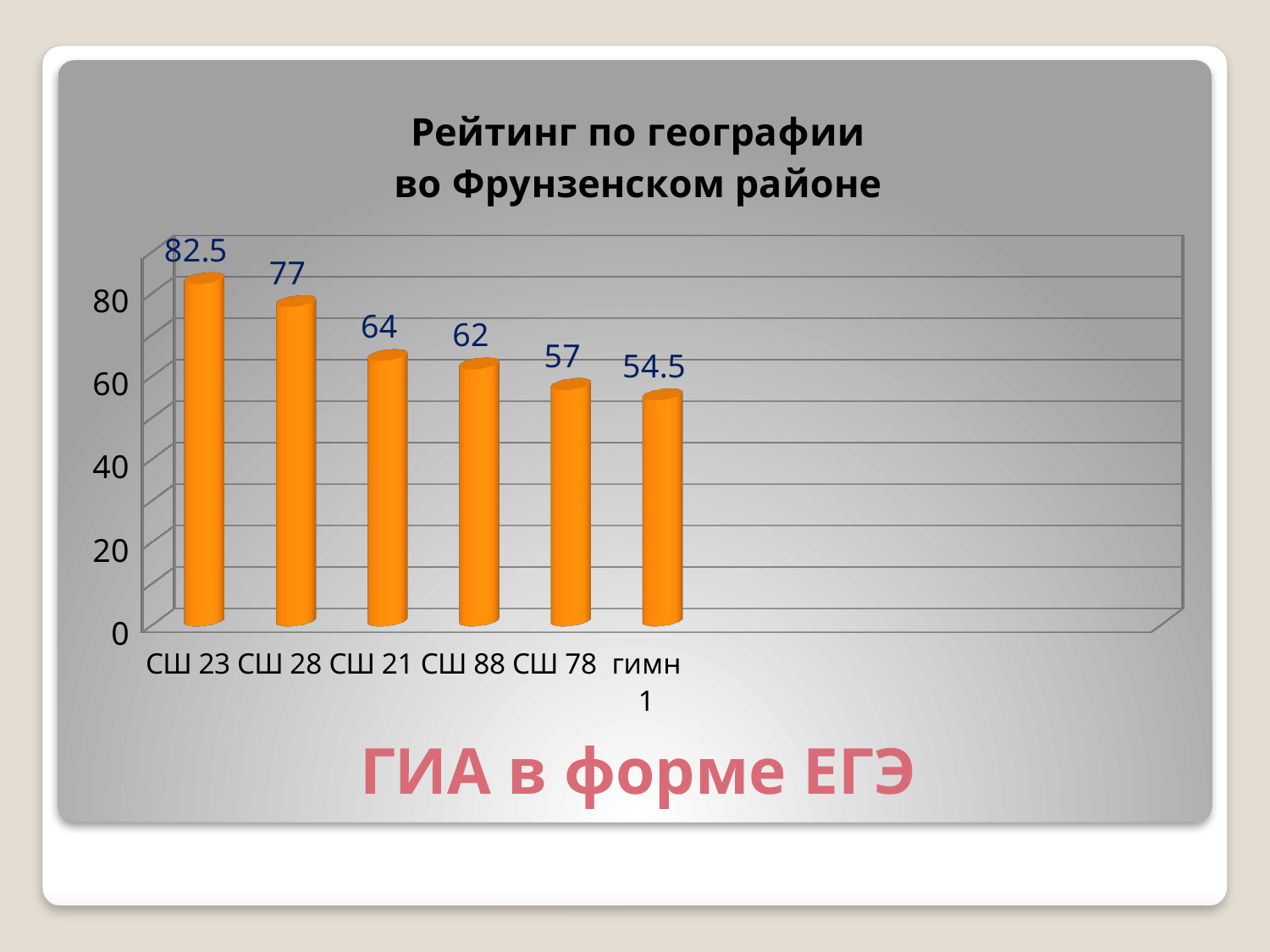
What is the value for гимн 1? 54.5 Is the value for СШ 78 greater or less than 60? less What is the difference between the values for СШ 23 and СШ 28? 5.5 Which category has the lowest value? гимн 1 What is the value for СШ 23? 82.5 Do the values rise or fall from left to right along the x axis? fall What is the difference between the values for СШ 21 and СШ 78? 7 Which is larger, the value for СШ 28 or the value for СШ 21? СШ 28 What kind of chart is shown on the slide? bar chart How many categories are shown on the chart? 6 Which category has the highest value? СШ 23 What is the value for СШ 88? 62